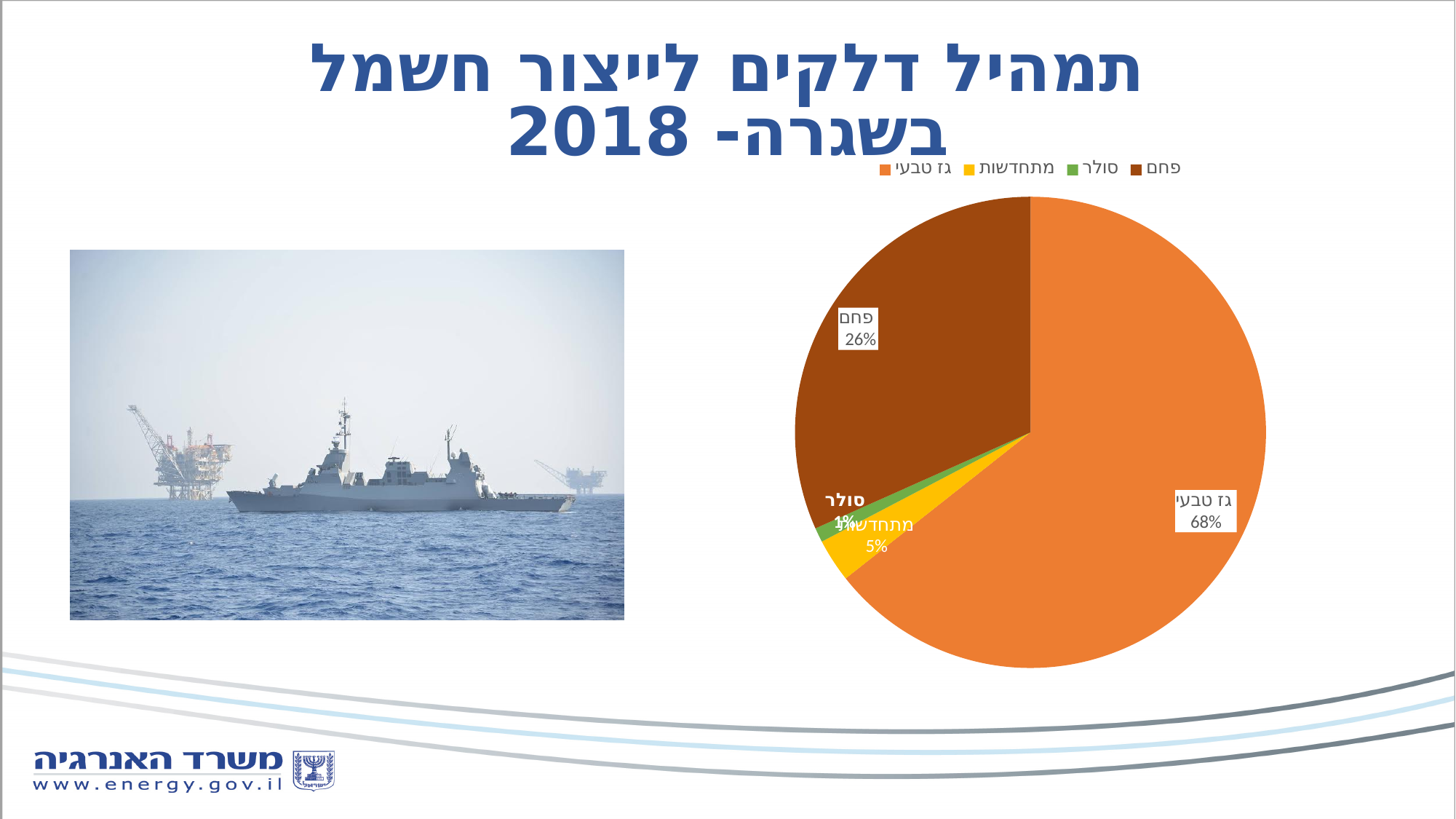
What share of the pie does גז טבעי (natural gas) hold? 68% How many slices does the pie chart have? 4 Which fuel has the smallest slice of the pie? סולר What share of the pie does מתחדשות (renewables) hold? 5% What is the difference in percentage points between the גז טבעי slice and the פחם slice? 42 Which fuel has the largest slice of the pie? גז טבעי Which slice is larger, מתחדשות or סולר? מתחדשות What share of the pie does סולר (diesel) hold? 1% What colour is the גז טבעי slice? Orange What kind of chart is shown on the slide? Pie chart How many entries does the legend list? 4 What share of the pie does פחם (coal) hold? 26%